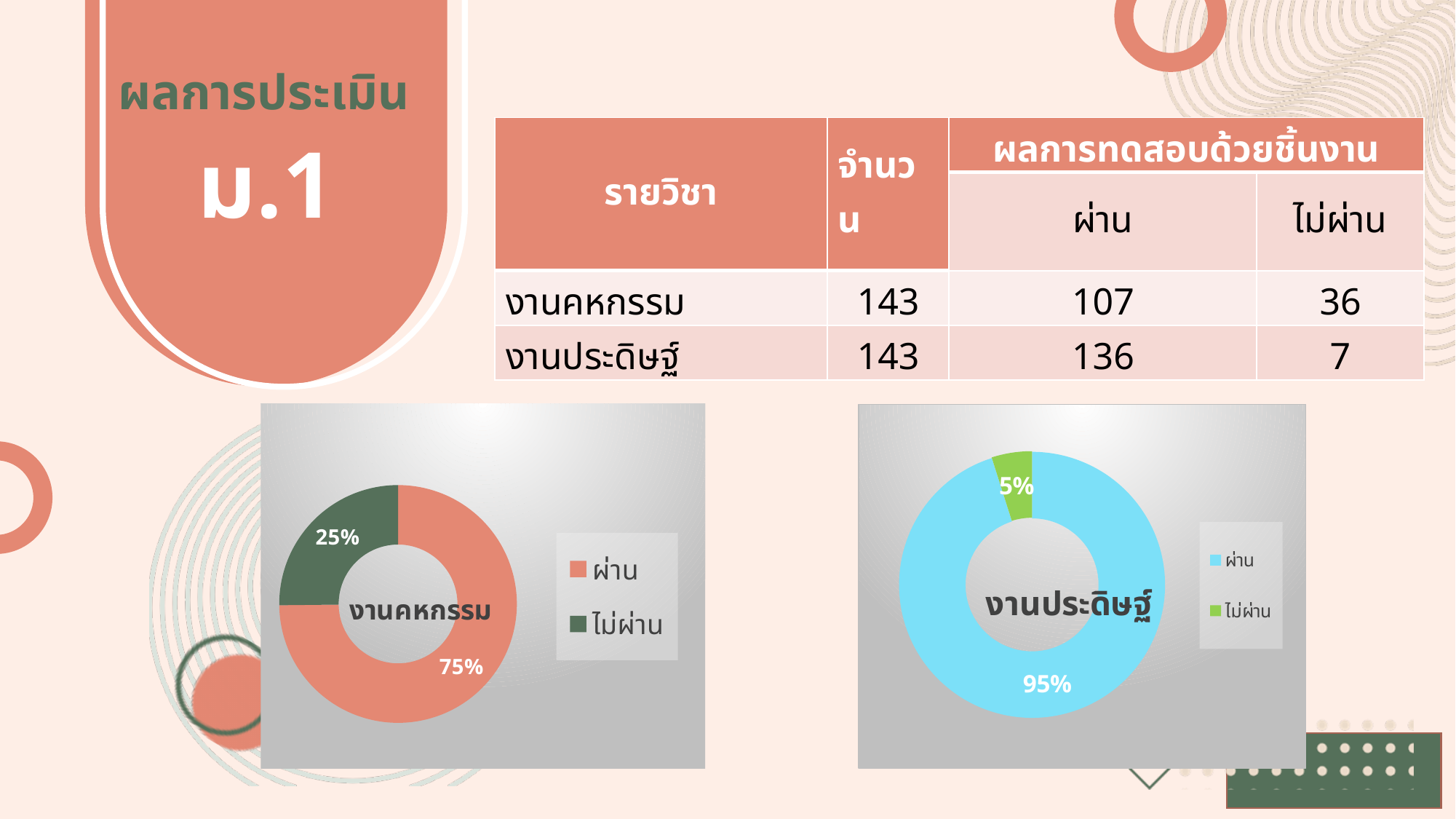
How many categories are shown in the งานคหกรรม chart? 2 In the งานประดิษฐ์ chart, what is the difference between the ผ่าน and ไม่ผ่าน shares? 90% Which chart shows a larger share for ผ่าน, งานคหกรรม or งานประดิษฐ์? งานประดิษฐ์ In the งานคหกรรม chart, which category has the largest share? ผ่าน In the งานคหกรรม chart, what percentage is shown for ไม่ผ่าน? 25% In the งานคหกรรม chart, what is the difference between the ผ่าน and ไม่ผ่าน shares? 50% How many series does the legend of the งานประดิษฐ์ chart list? 2 In the งานประดิษฐ์ chart, what percentage is shown for ผ่าน? 95% What kind of chart is the งานประดิษฐ์ chart? Doughnut chart In the งานประดิษฐ์ chart, what percentage is shown for ไม่ผ่าน? 5% In the งานคหกรรม chart, what percentage is shown for ผ่าน? 75% In the งานประดิษฐ์ chart, which category has the smallest share? ไม่ผ่าน